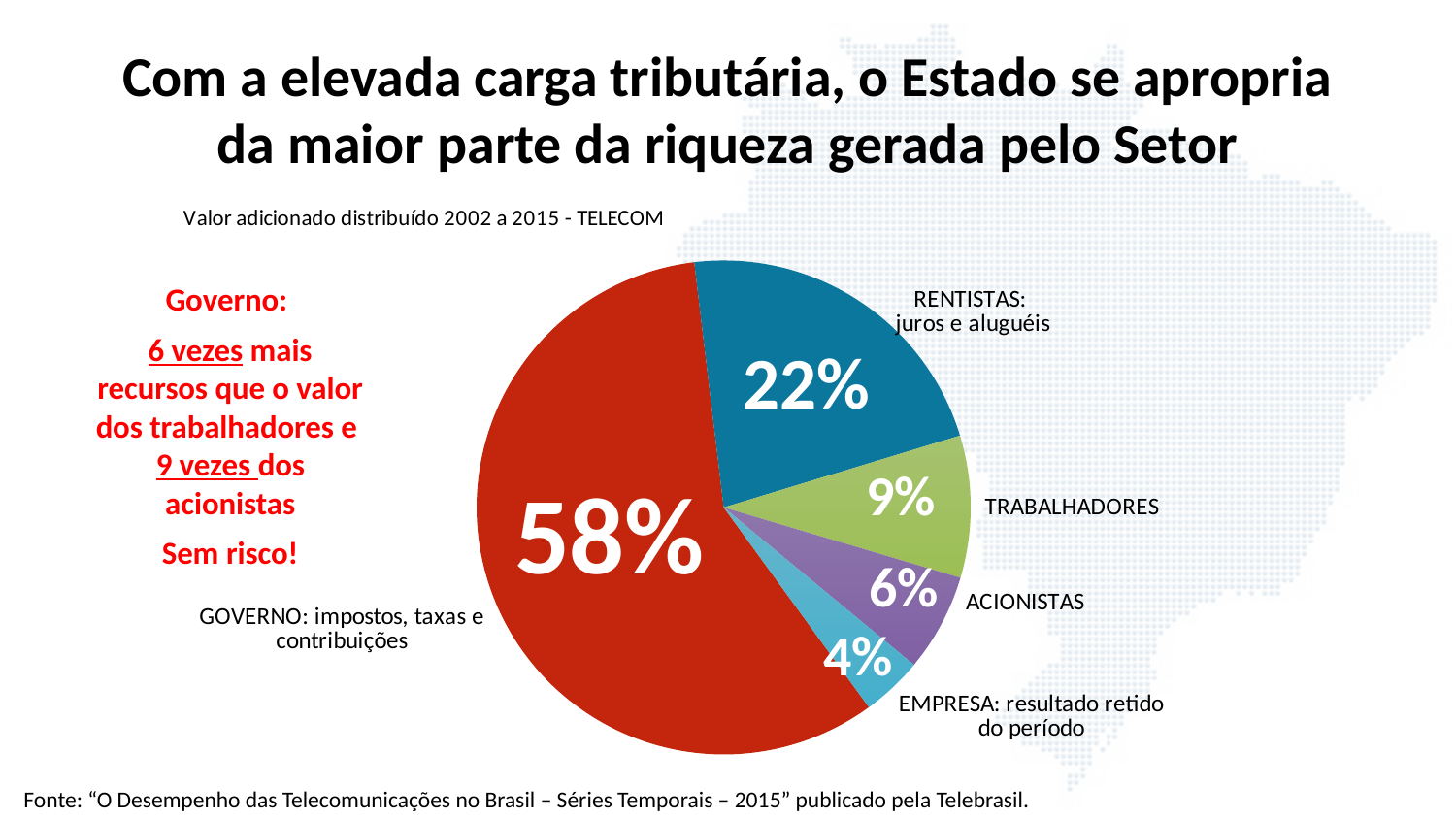
How many slices does the pie chart have? 5 What is the value shown for TRABALHADORES? 9% What share of the pie does GOVERNO: impostos, taxas e contribuições hold? 58% Which category has the smallest slice of the pie? EMPRESA: resultado retido do período What is the difference between the GOVERNO share and the RENTISTAS share? 36% Which category has the largest slice of the pie? GOVERNO: impostos, taxas e contribuições What is the value shown for EMPRESA: resultado retido do período? 4% What is the value shown for ACIONISTAS? 6% Which is larger, the share for TRABALHADORES or the share for ACIONISTAS? TRABALHADORES What is the title of the chart? Valor adicionado distribuído 2002 a 2015 - TELECOM What kind of chart is shown on the slide? Pie chart What share of the pie does RENTISTAS: juros e aluguéis hold? 22%